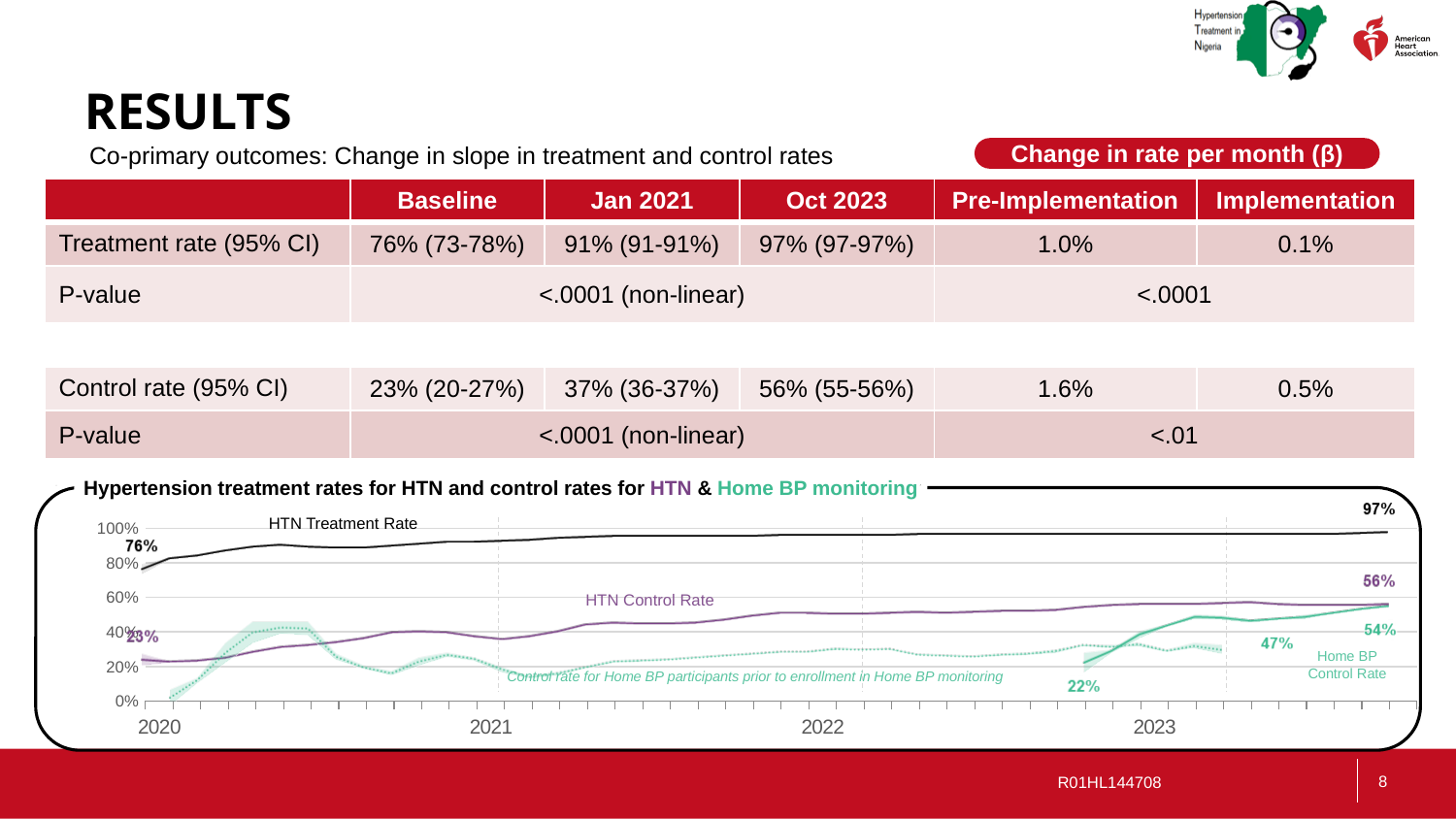
In the chart, which is higher at the end of the series: the HTN Control Rate (56%) or the Home BP Control Rate (54%)? HTN Control Rate What type of chart is shown at the bottom of the slide? line chart In the chart, what is the final labelled value of the HTN Treatment Rate? 97% In the chart, what is the HTN Control Rate at the start of 2020? 23% In the chart, what is the final labelled value of the Home BP Control Rate? 54% In the chart, by how many percentage points did the HTN Treatment Rate rise from its first label (76%) to its last label (97%)? 21 percentage points In the chart, by how many percentage points did the HTN Control Rate rise from its first label (23%) to its last label (56%)? 33 percentage points In the chart, is the HTN Treatment Rate during 2022 greater or less than 80%? greater In the chart, which series has the highest value at the end of 2023? HTN Treatment Rate In the chart, does the HTN Treatment Rate rise or fall from 2020 to 2023? rise In the chart, what is the final labelled value of the HTN Control Rate? 56% In the chart, what is the HTN Treatment Rate at the start of 2020? 76%